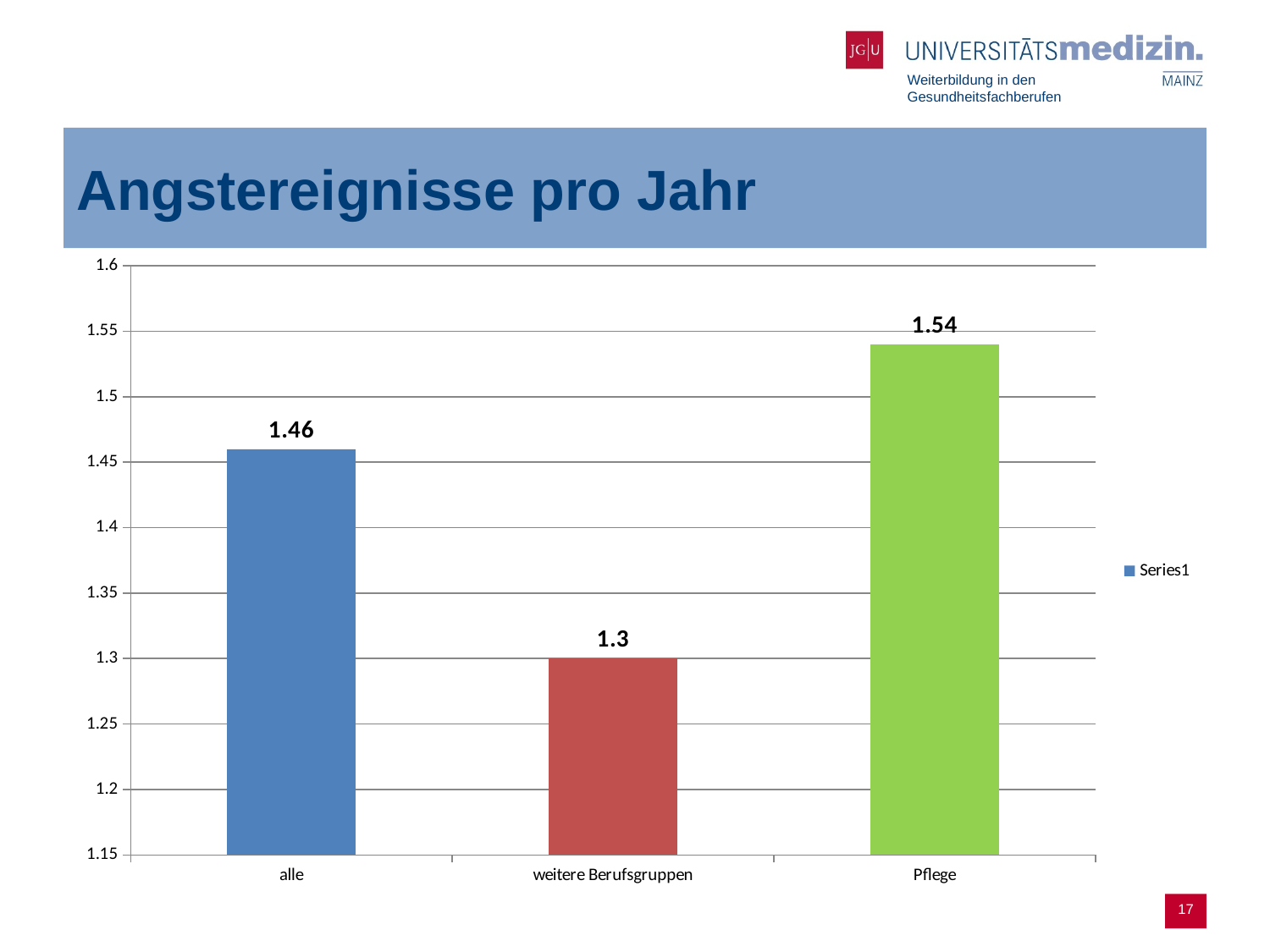
Which category has the lowest value? weitere Berufsgruppen Which is larger, the value for alle or the value for weitere Berufsgruppen? alle What kind of chart is shown on the slide? bar chart What is the value for "weitere Berufsgruppen"? 1.3 What is the value for "alle"? 1.46 What is the difference between the values for Pflege and weitere Berufsgruppen? 0.24 Which category has the highest value? Pflege What is the value for "Pflege"? 1.54 What is the title of the chart? Angstereignisse pro Jahr Is the value for Pflege greater or less than 1.5? greater How many categories are shown on the x axis? 3 What is the difference between the values for Pflege and alle? 0.08